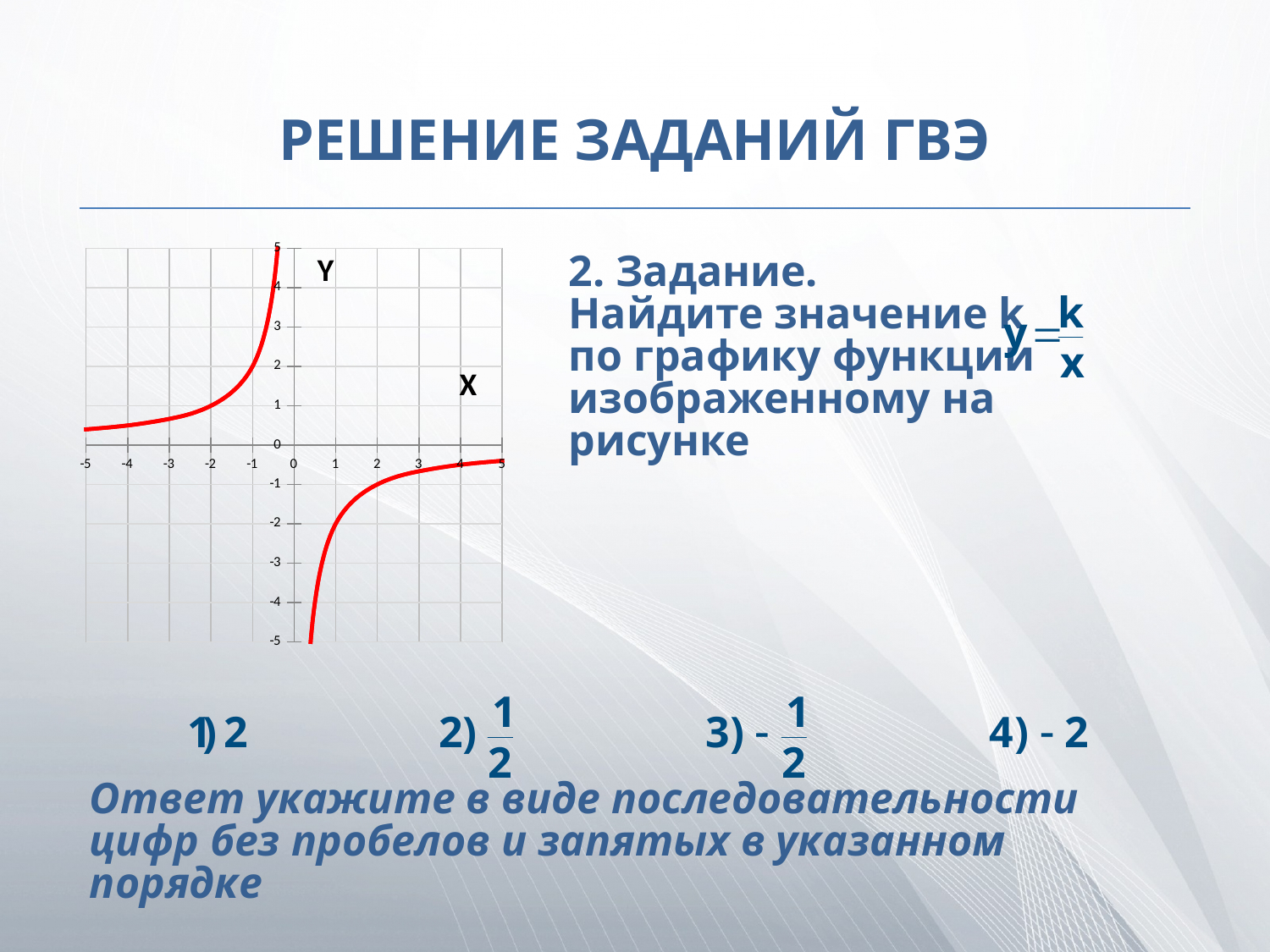
For positive x, does the curve rise or fall as x increases? rises Is the value of the curve at x = -4 greater or less than 2? less How many curves are plotted on the graph? 1 What is the highest value labelled on the x axis of the graph? 5 Is the value of the curve at x = -1 greater or less than 0? greater Is the value of the curve at x = 1 greater or less than 0? less What colour is the plotted curve on the graph? red Which is larger: the value of the curve at x = -2 or at x = 2? at x = -2 What kind of chart is shown on the slide? line chart (graph of a function)